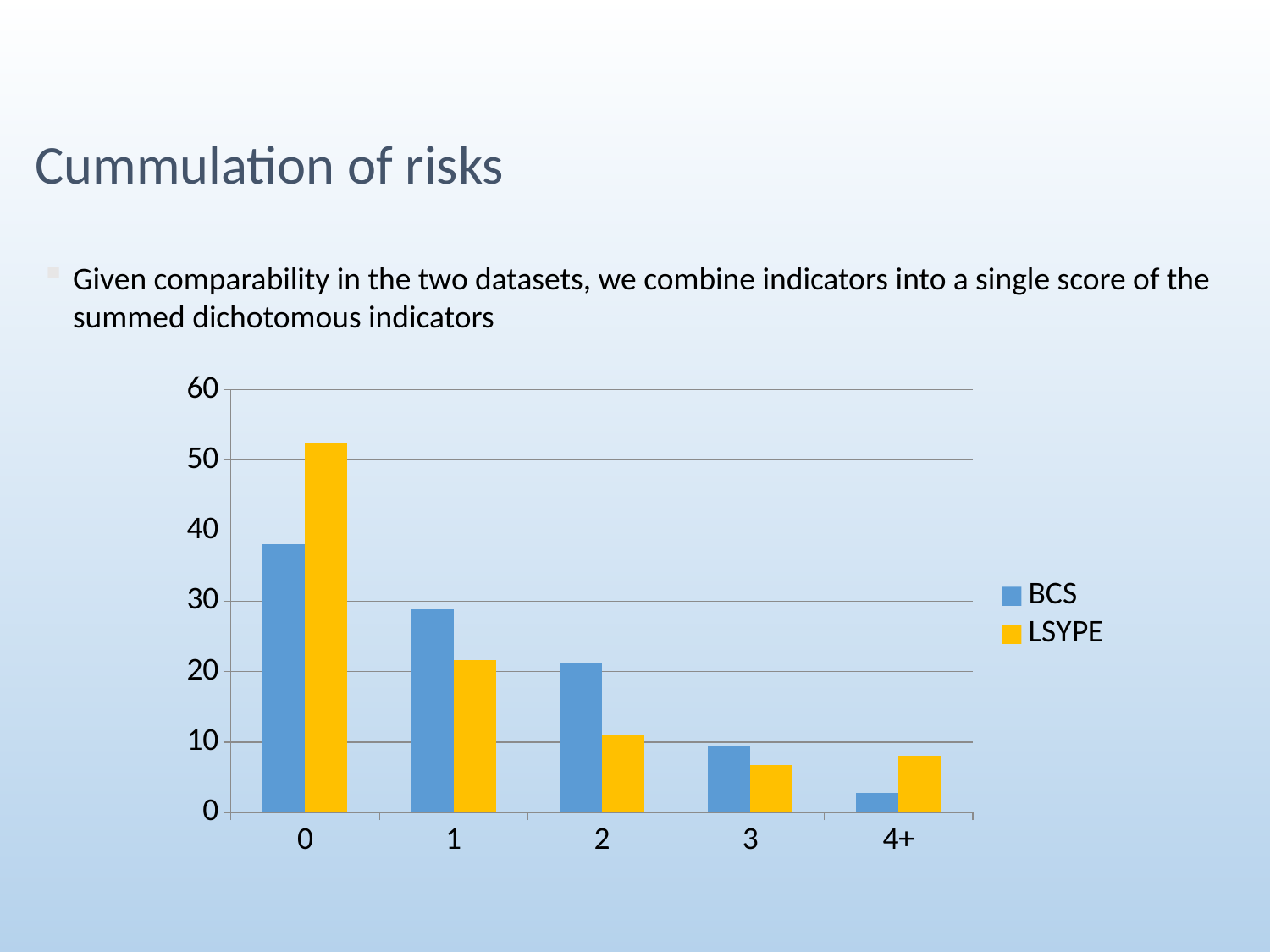
How many categories are shown on the x axis of the chart? 5 Do the BCS values rise or fall as you move from category 0 to category 4+? fall For category 0, which series has the larger value, BCS or LSYPE? LSYPE Which category has the lowest BCS value? 4+ Is the LSYPE value for category 0 greater or less than 50? greater How many series does the chart's legend list? 2 What kind of chart is shown on the slide? bar chart Is the BCS value for category 4+ greater or less than 10? less Which colour represents the LSYPE series in the chart? yellow Which category has the highest BCS value? 0 For category 1, which series has the larger value, BCS or LSYPE? BCS Which category has the highest LSYPE value? 0